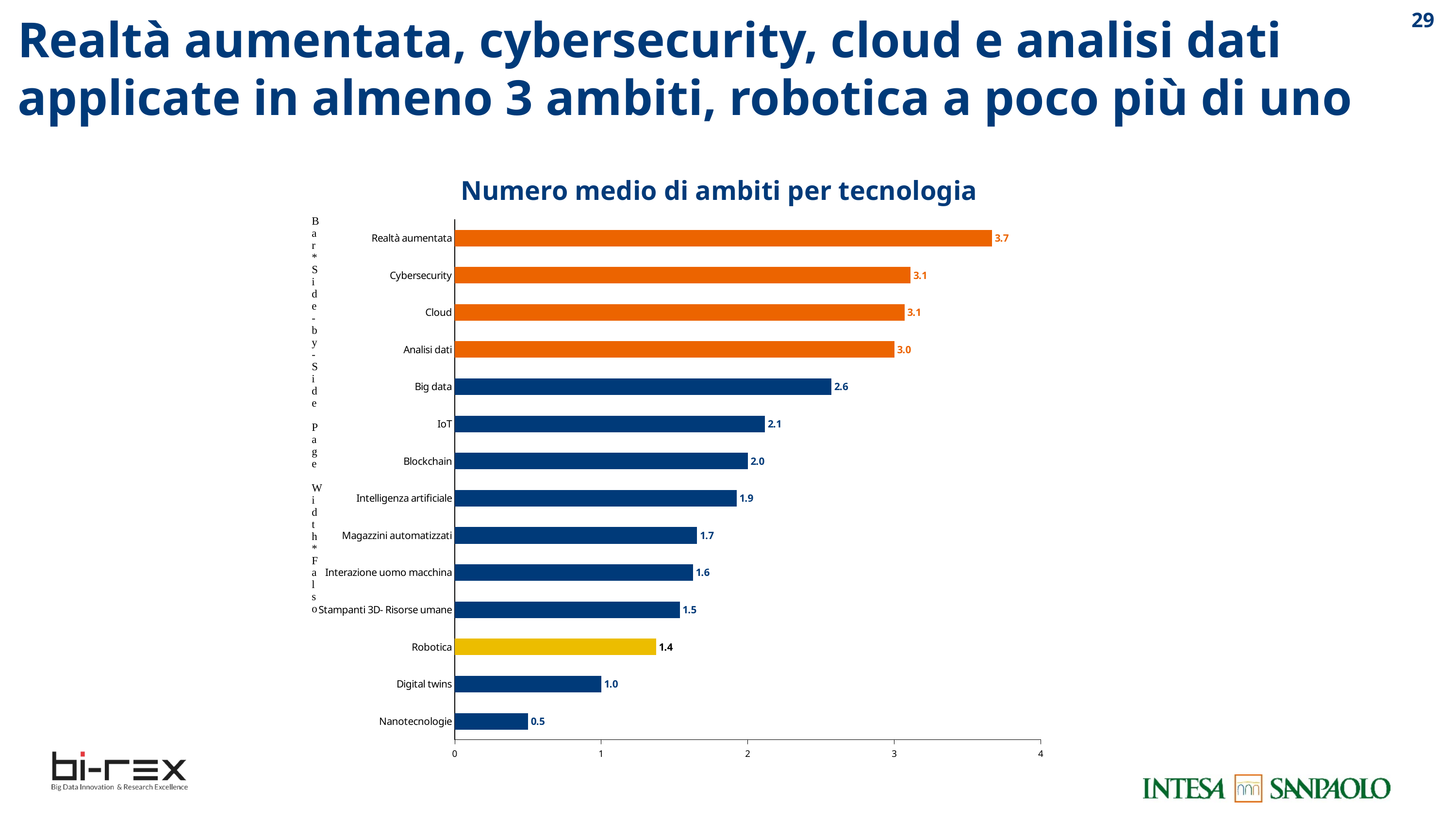
What is the difference between the values for Big data and IoT? 0.5 Which technology has the lowest average number of ambiti? Nanotecnologie What is the difference between the values for Realtà aumentata and Nanotecnologie? 3.2 How many technologies are shown in the chart? 14 What is the title of the chart? Numero medio di ambiti per tecnologia What is the value for Realtà aumentata? 3.7 What is the value for Big data? 2.6 What is the value for Robotica? 1.4 What kind of chart is shown on the slide? Bar chart Which is larger, the value for Blockchain or the value for Magazzini automatizzati? Blockchain Is the value for Analisi dati greater or less than 2? greater Which technology has the highest average number of ambiti? Realtà aumentata